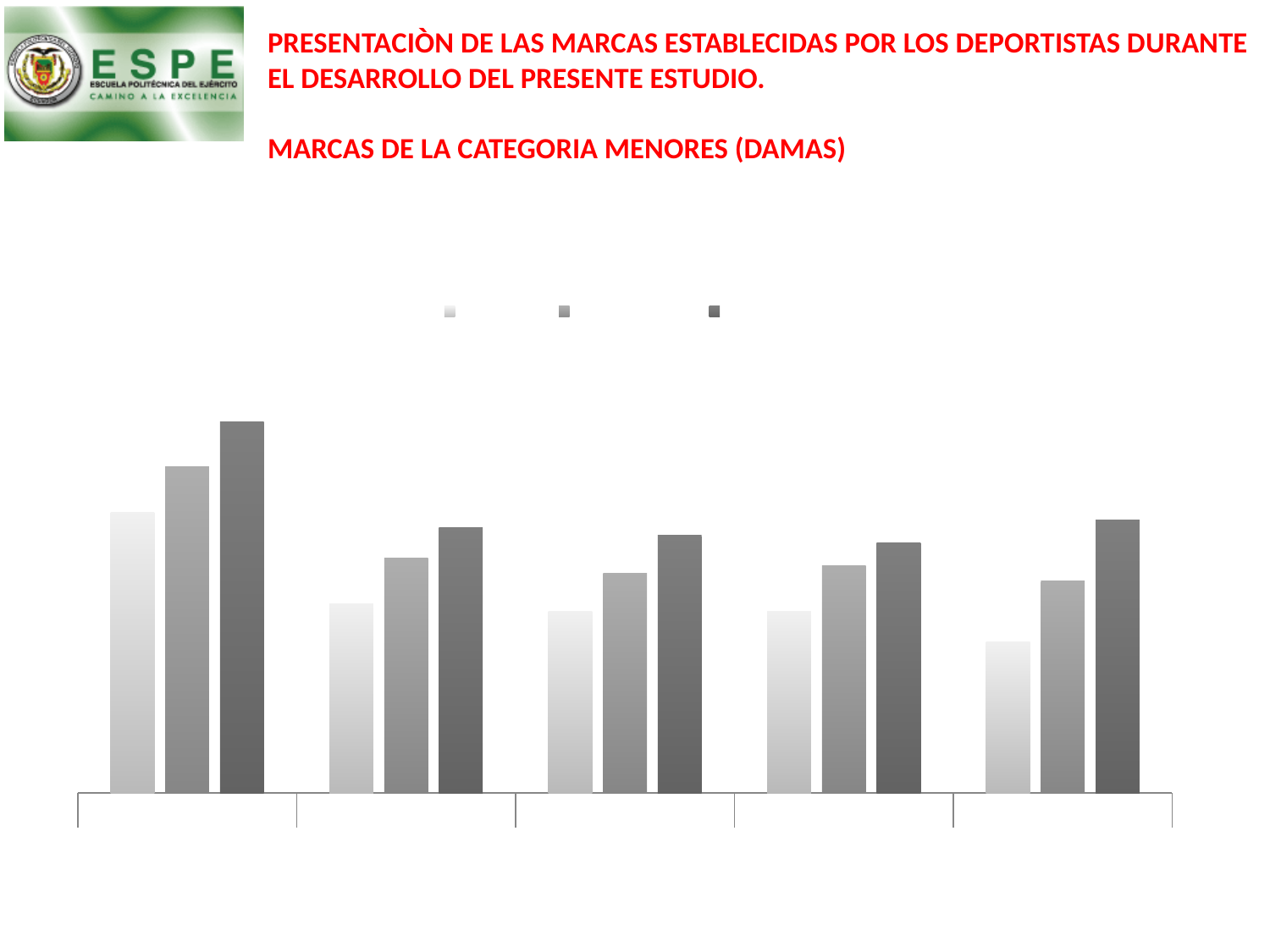
Which category group, by position from the left, has the shortest lightest-coloured bar? the fifth (rightmost) group What colours are used for the three series in the chart? light grey, medium grey and dark grey How many bars are in each category group? 3 Which category group, by position from the left, has the tallest bars overall? the first (leftmost) group How many groups of bars (categories) are plotted along the x axis? 5 What kind of chart is shown on the slide? bar chart How many series does the legend show? 3 Within each category group, which bar is the shortest: the lightest, the medium grey, or the darkest? the lightest Does the chart display any numeric axis values or data labels? No Is the lightest bar in the first (leftmost) group taller or shorter than the lightest bar in the last (rightmost) group? taller Within each category group, which bar is the tallest: the lightest, the medium grey, or the darkest? the darkest